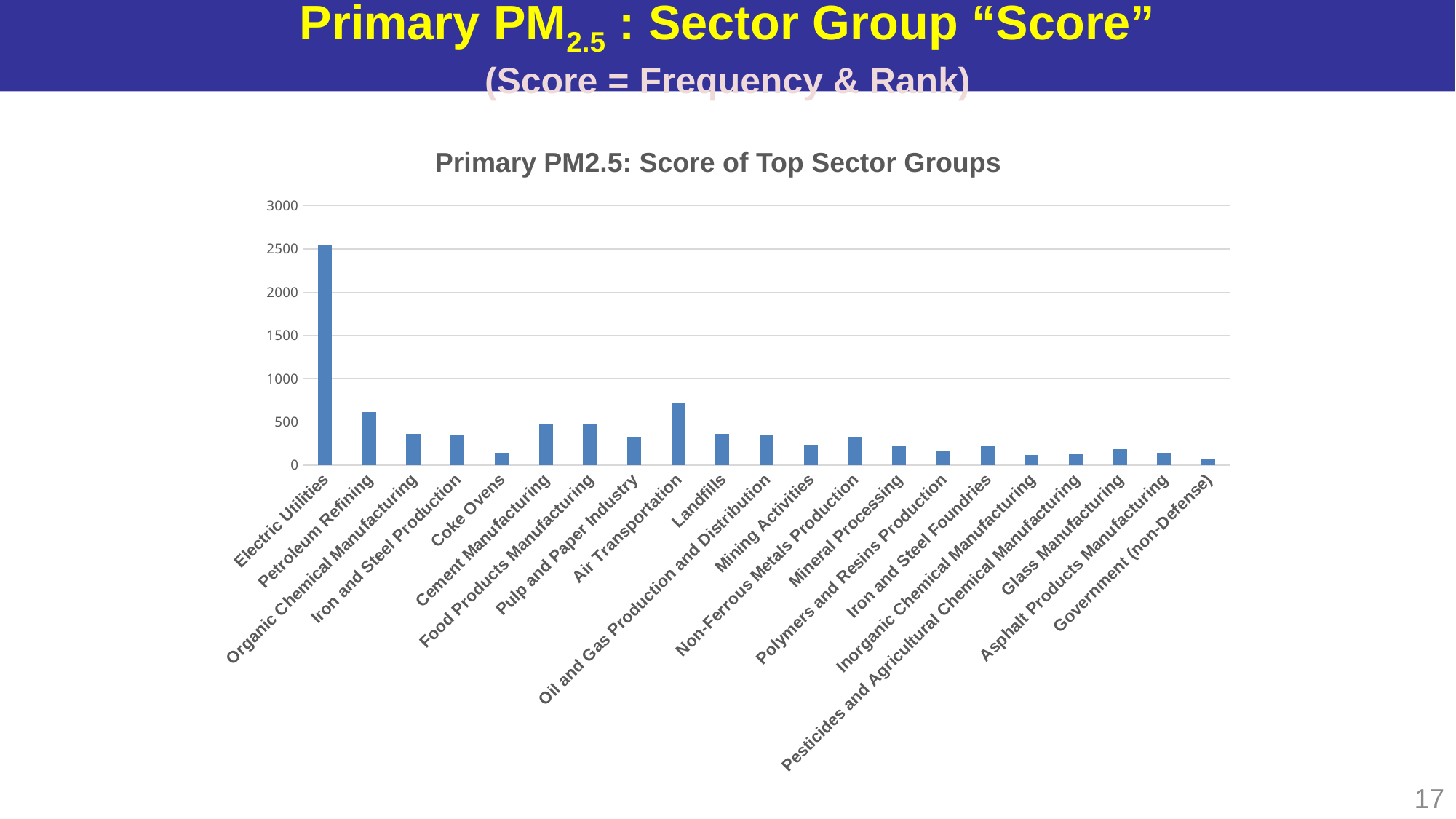
Which sector group has the lowest score? Government (non-Defense) What is the highest value shown on the vertical axis? 3000 Which has a higher score, Petroleum Refining or Landfills? Petroleum Refining What kind of chart is shown on the slide? Bar chart What is the title of the chart? Primary PM2.5: Score of Top Sector Groups How many sector groups are plotted on the chart? 21 Is the score for Air Transportation greater or less than 500? greater Is the score for Coke Ovens greater or less than 500? less Is the score for Landfills greater or less than 500? less Which has a higher score, Air Transportation or Petroleum Refining? Air Transportation Which sector group has the highest score? Electric Utilities